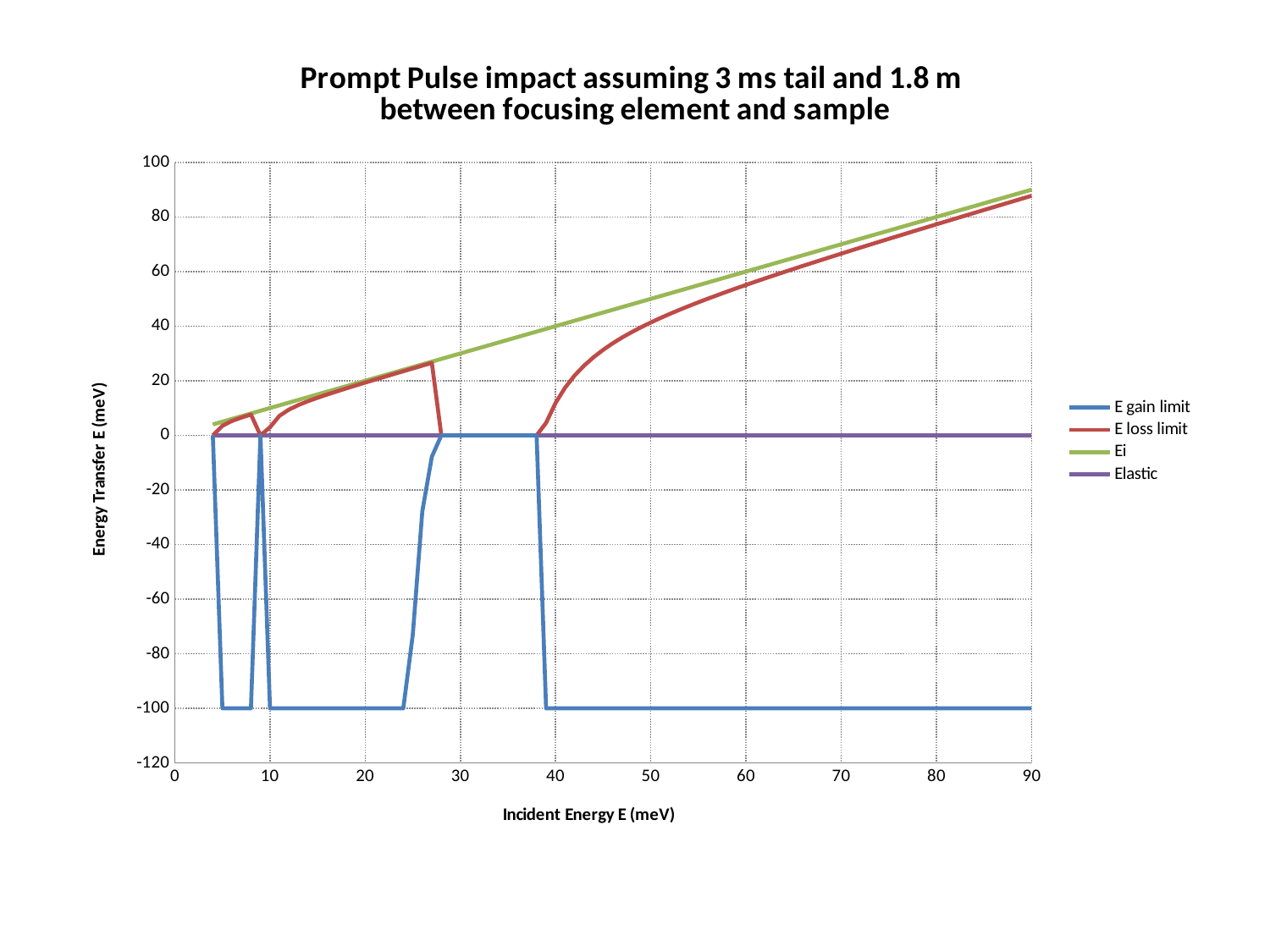
What is the value of the Ei series at an incident energy of 80 meV? 80 At an incident energy of 60 meV, which series has the higher value, Ei or E loss limit? Ei What is the title of the chart? Prompt Pulse impact assuming 3 ms tail and 1.8 m between focusing element and sample What is the value of the Elastic series at an incident energy of 50 meV? 0 Is the value of the E loss limit series at an incident energy of 60 meV greater or less than 40? greater How many series does the legend list? 4 Is the value of the E loss limit series at an incident energy of 40 meV greater or less than 20? less What kind of chart is shown on the slide? line chart Does the Ei series rise or fall as incident energy increases? rise Which series has the lowest value at an incident energy of 70 meV? E gain limit What is the label of the x axis? Incident Energy E (meV) What is the value of the E gain limit series at an incident energy of 60 meV? -100